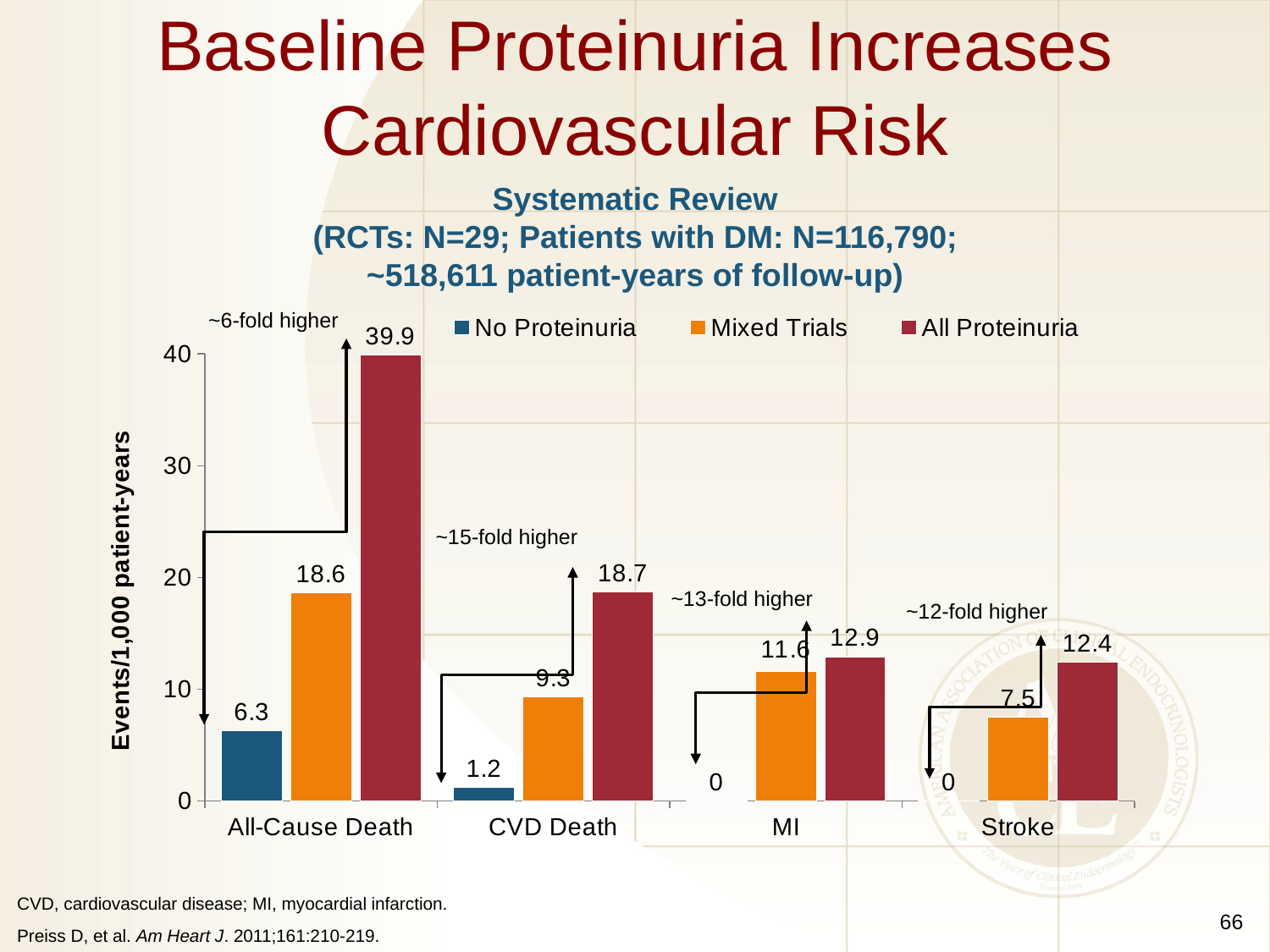
What is the label of the y axis? Events/1,000 patient-years Which category has the highest All Proteinuria value? All-Cause Death How many categories are shown on the x axis? 4 How many series does the legend list? 3 What is the value for Mixed Trials in the Stroke category? 7.5 What is the difference between the All Proteinuria and No Proteinuria values for All-Cause Death? 33.6 Which category has the lowest Mixed Trials value? Stroke What is the value for No Proteinuria in the CVD Death category? 1.2 What is the value for All Proteinuria in the All-Cause Death category? 39.9 What kind of chart is shown on the slide? Bar chart Which is larger for CVD Death: the Mixed Trials value or the All Proteinuria value? All Proteinuria What is the value for Mixed Trials in the MI category? 11.6